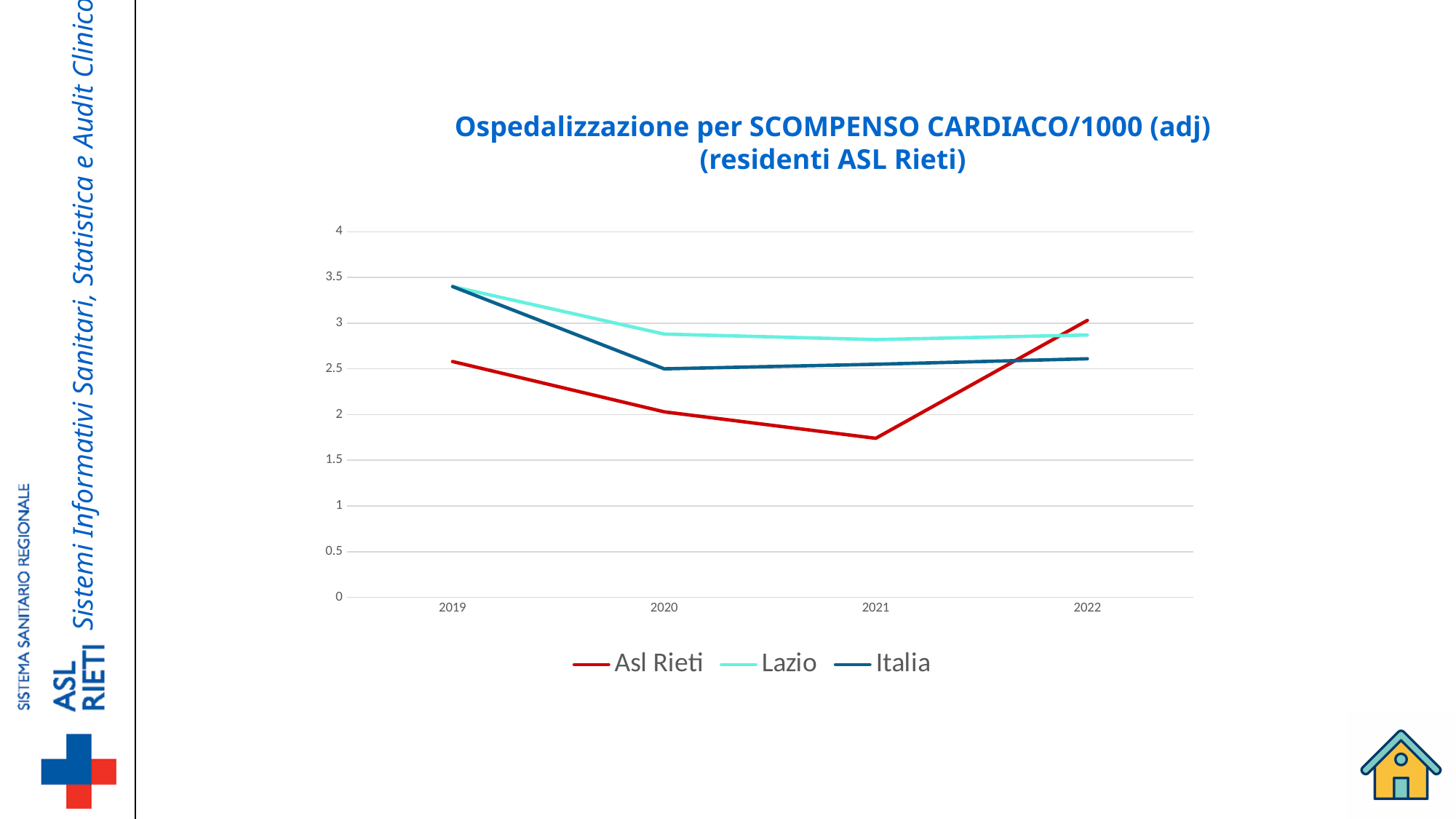
In which year is the Asl Rieti value lowest? 2021 Is the Asl Rieti value for 2021 greater or less than 2? less Which series is drawn in red? Asl Rieti Is the Italia value for 2020 greater or less than 3? less In 2022, which is larger: the Asl Rieti value or the Italia value? Asl Rieti Is the Lazio value for 2019 greater or less than 3? greater In 2021, which is larger: the Asl Rieti value or the Lazio value? Lazio In which year is the Asl Rieti value highest? 2022 Does the Italia line rise or fall from 2019 to 2020? fall How many years are plotted along the x axis? 4 What kind of chart is shown on the slide? line chart How many series does the legend list? 3